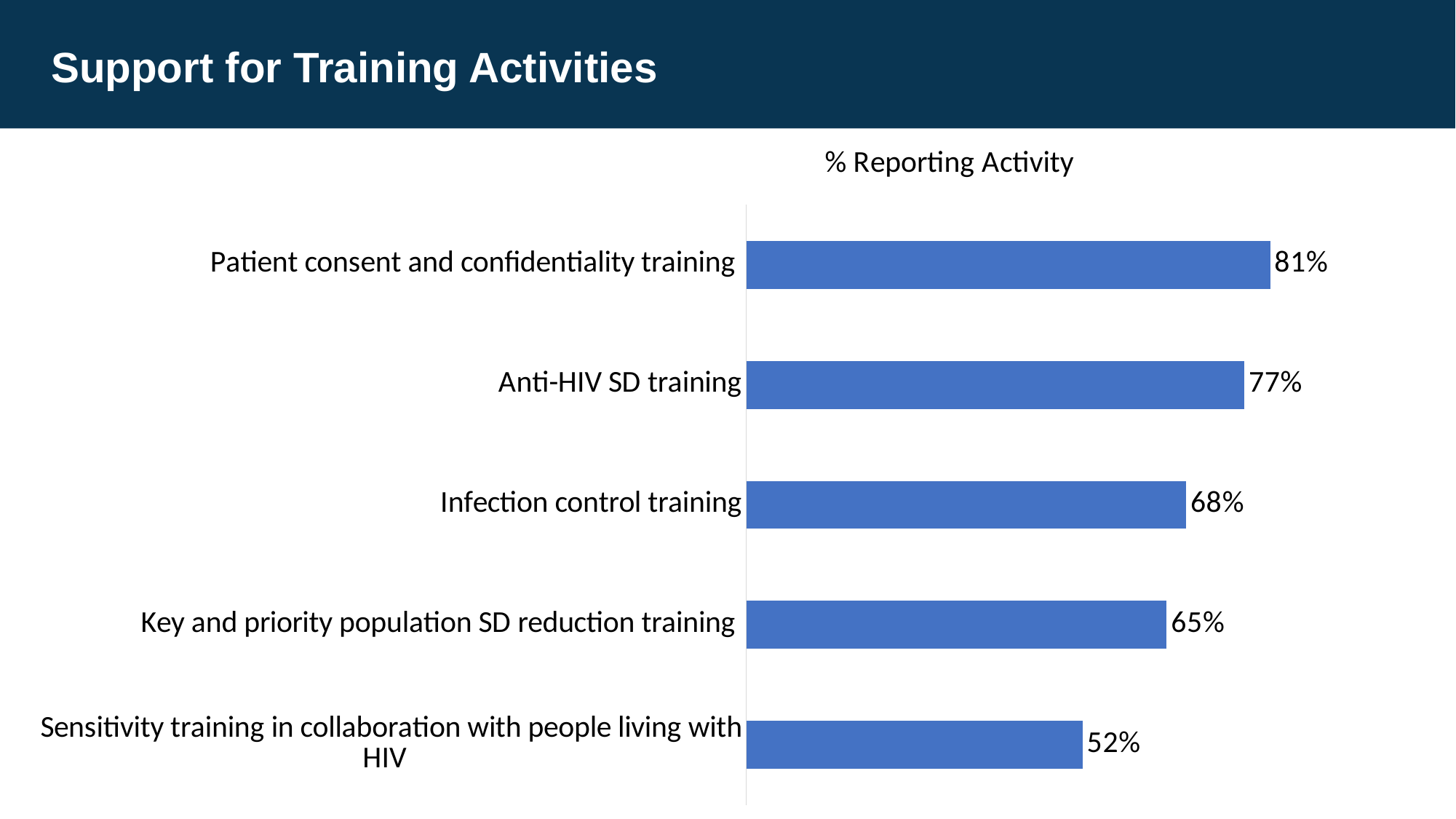
What is the value for Sensitivity training in collaboration with people living with HIV? 52% What is the title of the chart? % Reporting Activity What kind of chart is shown on the slide? Bar chart What is the difference between Infection control training and Sensitivity training in collaboration with people living with HIV? 16% Which training activity has the lowest percentage reporting? Sensitivity training in collaboration with people living with HIV Which training activity has the highest percentage reporting? Patient consent and confidentiality training What percentage reported Infection control training? 68% How many training activities are shown in the chart? 5 What is the difference between Patient consent and confidentiality training and Anti-HIV SD training? 4% What percentage reported Patient consent and confidentiality training? 81% What is the value for Anti-HIV SD training? 77% Which is larger: Infection control training or Key and priority population SD reduction training? Infection control training